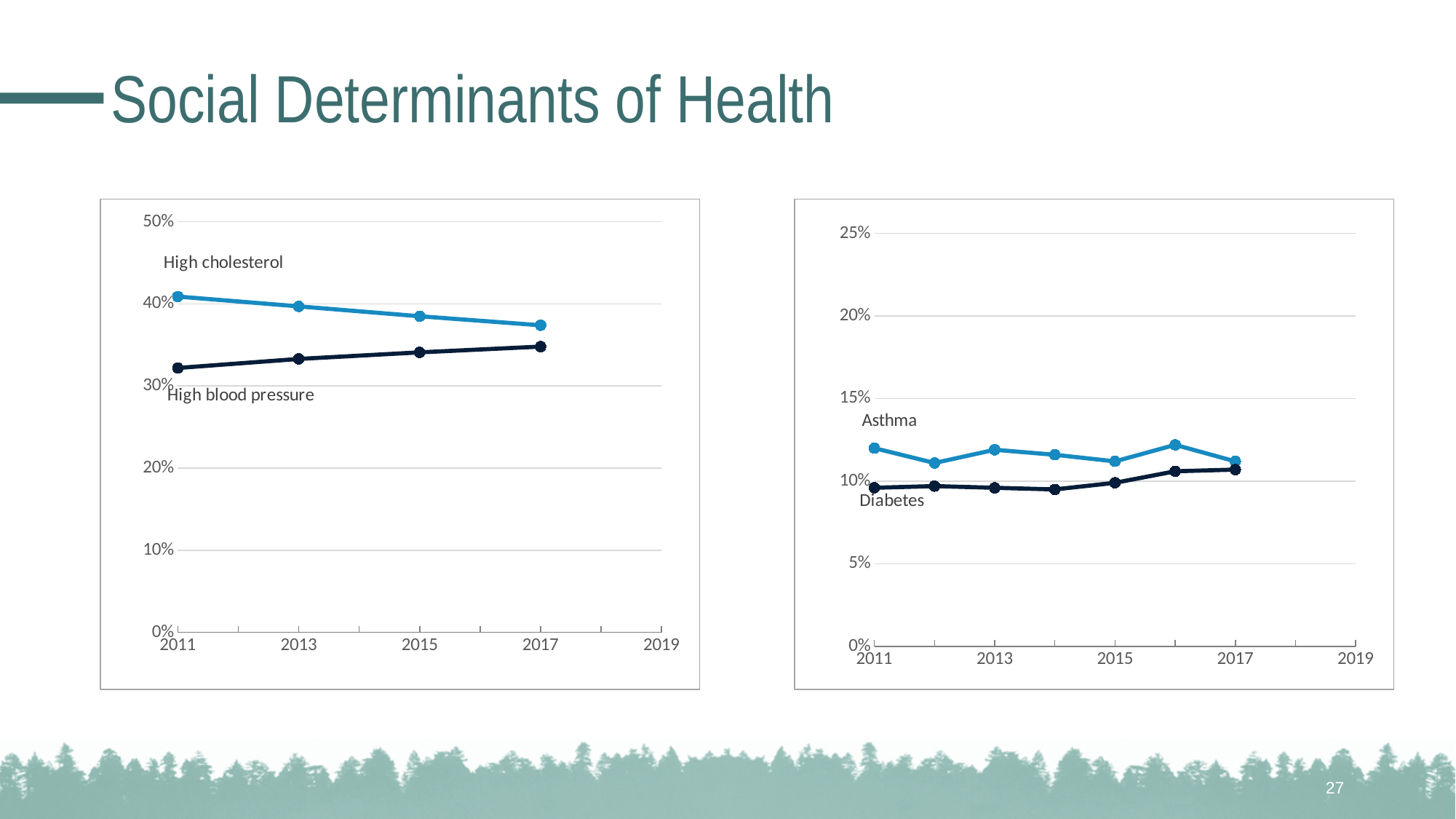
How many series does the left chart show? 2 In the left chart, does the High cholesterol line rise or fall from 2011 to 2017? fall How many data points does the Diabetes line in the right chart have? 7 In the left chart, which series has the higher value in 2011, High cholesterol or High blood pressure? High cholesterol In the left chart, is the value for High blood pressure in 2011 greater or less than 30%? greater In the right chart, is the value for Asthma in 2016 greater or less than 15%? less What kind of chart is the left chart on the slide? line chart How many data points does the High cholesterol line in the left chart have? 4 In the left chart, does the High blood pressure line rise or fall from 2011 to 2017? rise In the left chart, is the value for High cholesterol in 2017 greater or less than 40%? less In the right chart, which series has the higher value in 2011, Asthma or Diabetes? Asthma